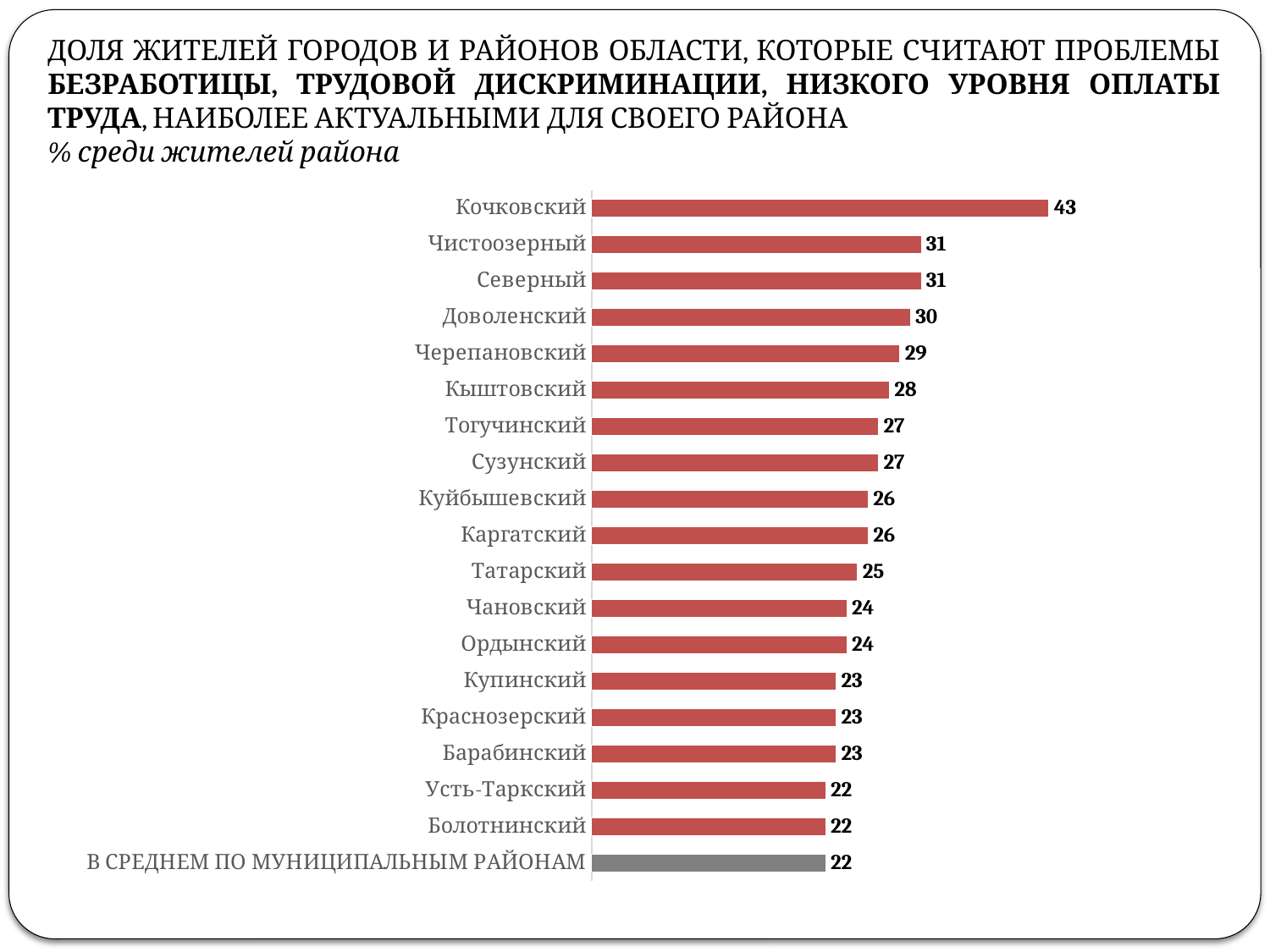
What kind of chart is shown on the slide? Bar chart What is the value for Доволенский? 30 What is the value for Татарский? 25 What is the value for Кочковский? 43 Which is larger, the value for Северный or the value for Ордынский? Северный What is the difference between the values for Кочковский and Чистоозерный? 12 What is the difference between the values for Черепановский and Болотнинский? 7 How many bars are plotted on the chart? 19 Which category has the highest value? Кочковский What is the value shown for В СРЕДНЕМ ПО МУНИЦИПАЛЬНЫМ РАЙОНАМ? 22 Which bar is shown in a different colour (grey) from the others? В СРЕДНЕМ ПО МУНИЦИПАЛЬНЫМ РАЙОНАМ Which is larger, the value for Кыштовский or the value for Купинский? Кыштовский